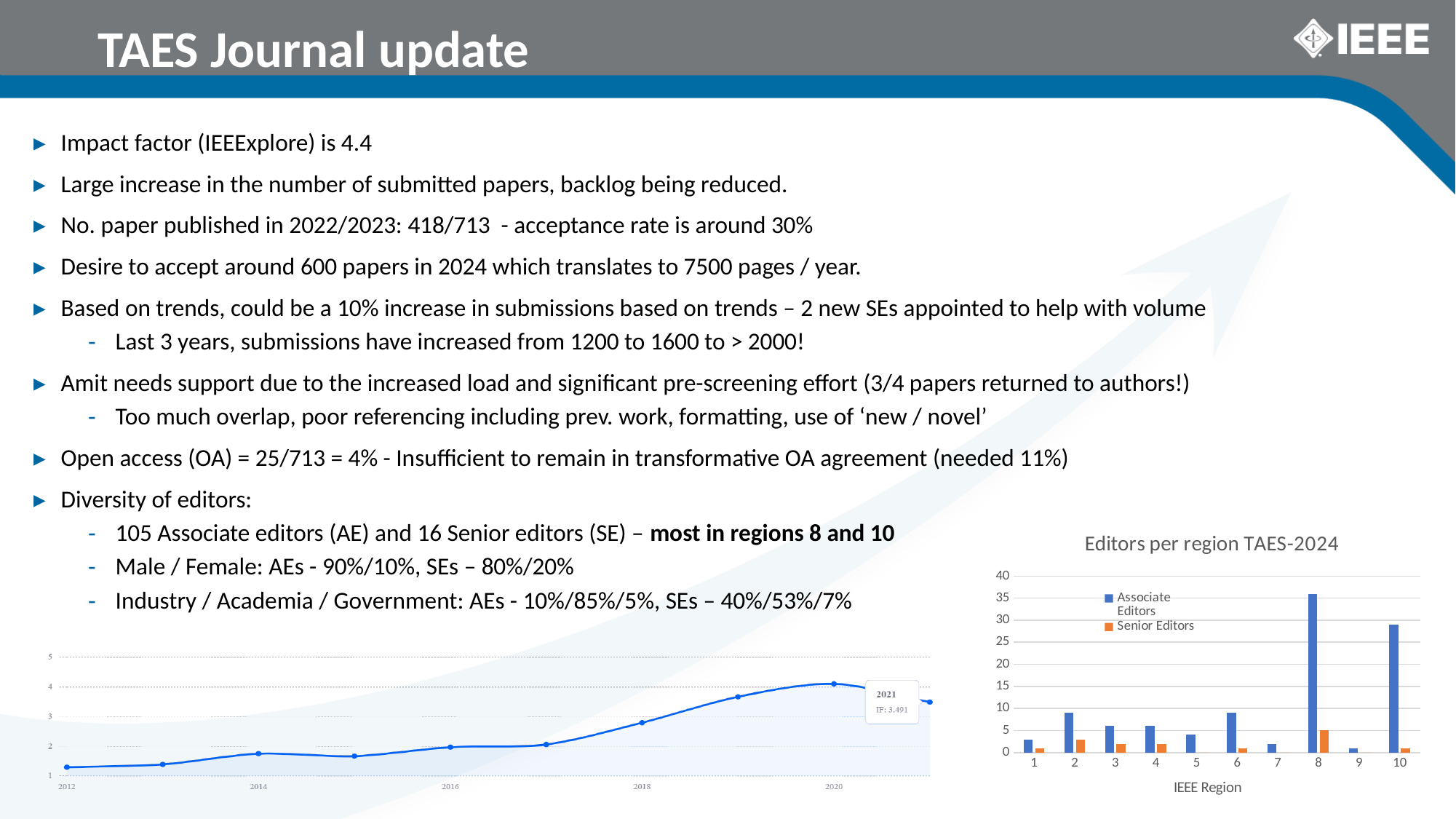
What kind of chart is the chart at the bottom left of the slide? line chart In the 'Editors per region TAES-2024' chart, is the number of Associate Editors in region 8 greater or less than 30? greater What is the title of the bar chart on the right of the slide? Editors per region TAES-2024 How many series does the legend of the 'Editors per region TAES-2024' chart list? 2 In the 'Editors per region TAES-2024' chart, which region has more Associate Editors, region 8 or region 10? region 8 How many IEEE regions are shown on the x axis of the 'Editors per region TAES-2024' chart? 10 What kind of chart is the 'Editors per region TAES-2024' chart? bar chart In the 'Editors per region TAES-2024' chart, is the number of Associate Editors in region 10 greater or less than 25? greater In the 'Editors per region TAES-2024' chart, is the number of Associate Editors in region 9 greater or less than 5? less In the line chart at the bottom left, what impact factor value is shown in the tooltip for 2021? 3.491 In the 'Editors per region TAES-2024' chart, which region has the highest number of Associate Editors? 8 In the 'Editors per region TAES-2024' chart, which region has the highest number of Senior Editors? 8